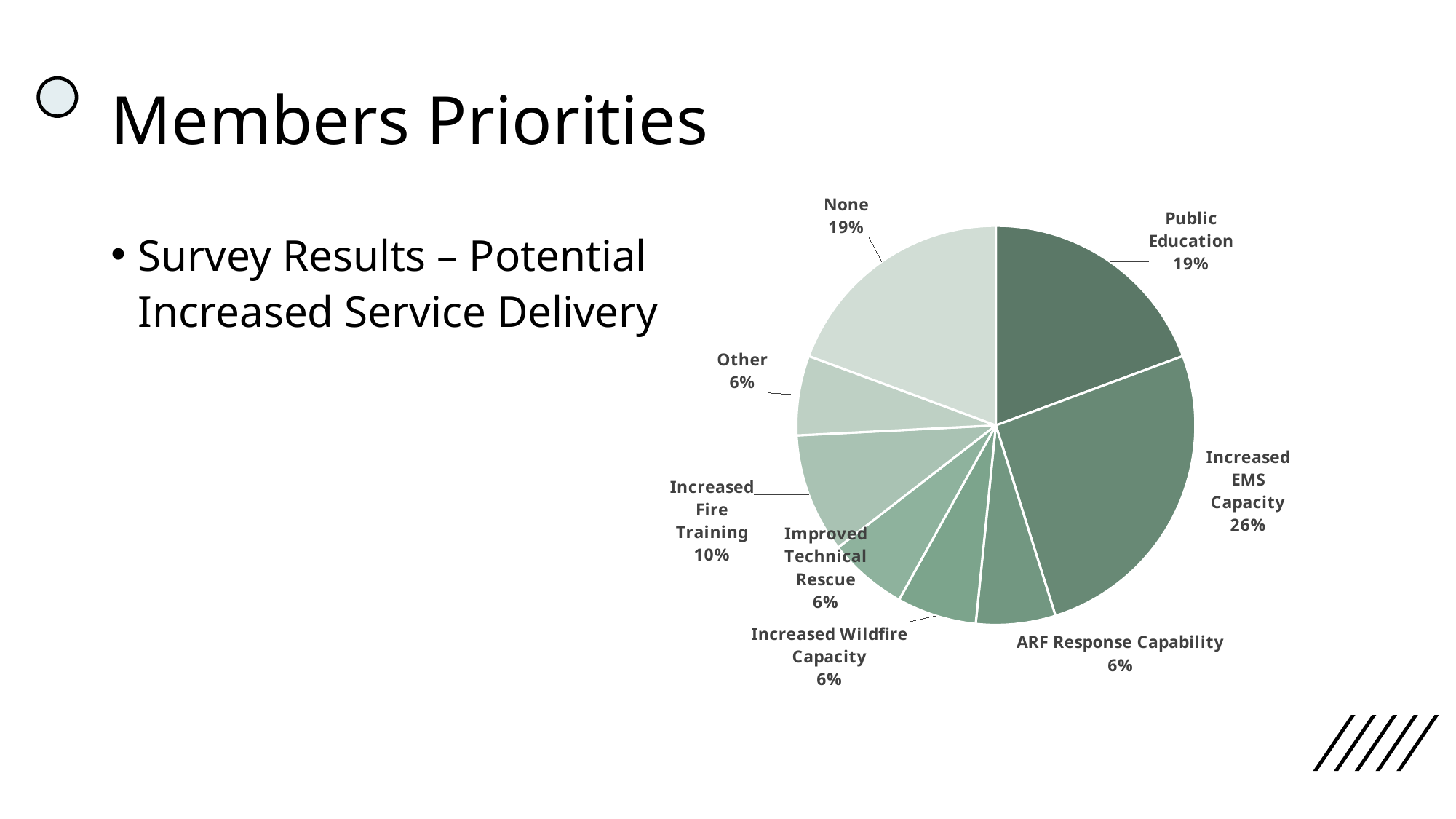
How many slices does the pie chart have? 8 Which category has the largest slice of the pie? Increased EMS Capacity How many categories are labelled with 6%? 4 What is the difference in percentage points between Increased Fire Training and Improved Technical Rescue? 4 percentage points What percentage is shown for Increased Fire Training? 10% What is the difference in percentage points between Increased EMS Capacity and Public Education? 7 percentage points What kind of chart is shown on the slide? Pie chart Which is larger, Increased Fire Training or Other? Increased Fire Training What share of the pie does Increased EMS Capacity represent? 26% What percentage is shown for Public Education? 19% What percentage is shown for ARF Response Capability? 6% What percentage is shown for None? 19%